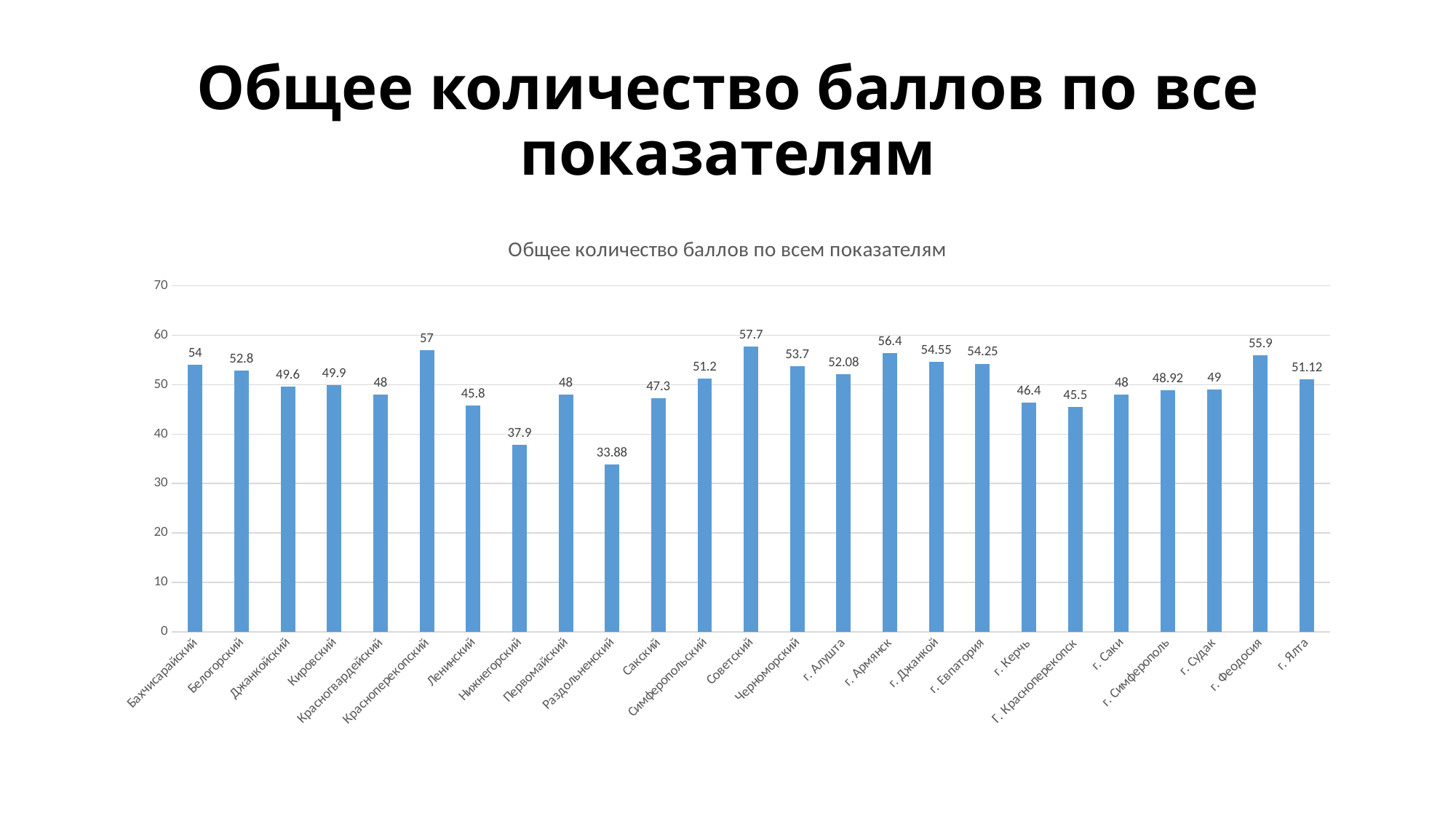
What kind of chart is shown on the slide? bar chart Which category has the highest value? Советский What is the difference between the values for г. Феодосия and г. Керчь? 9.5 Which category has the lowest value? Раздольненский What is the value for г. Симферополь? 48.92 What is the value for г. Алушта? 52.08 How many categories are shown on the x axis? 25 Is the value for Нижнегорский greater or less than 40? less Which is larger, the value for г. Армянск or the value for г. Алушта? г. Армянск What is the value for Красноперекопский? 57 What is the difference between the values for Советский and Раздольненский? 23.82 What is the title of the chart? Общее количество баллов по всем показателям